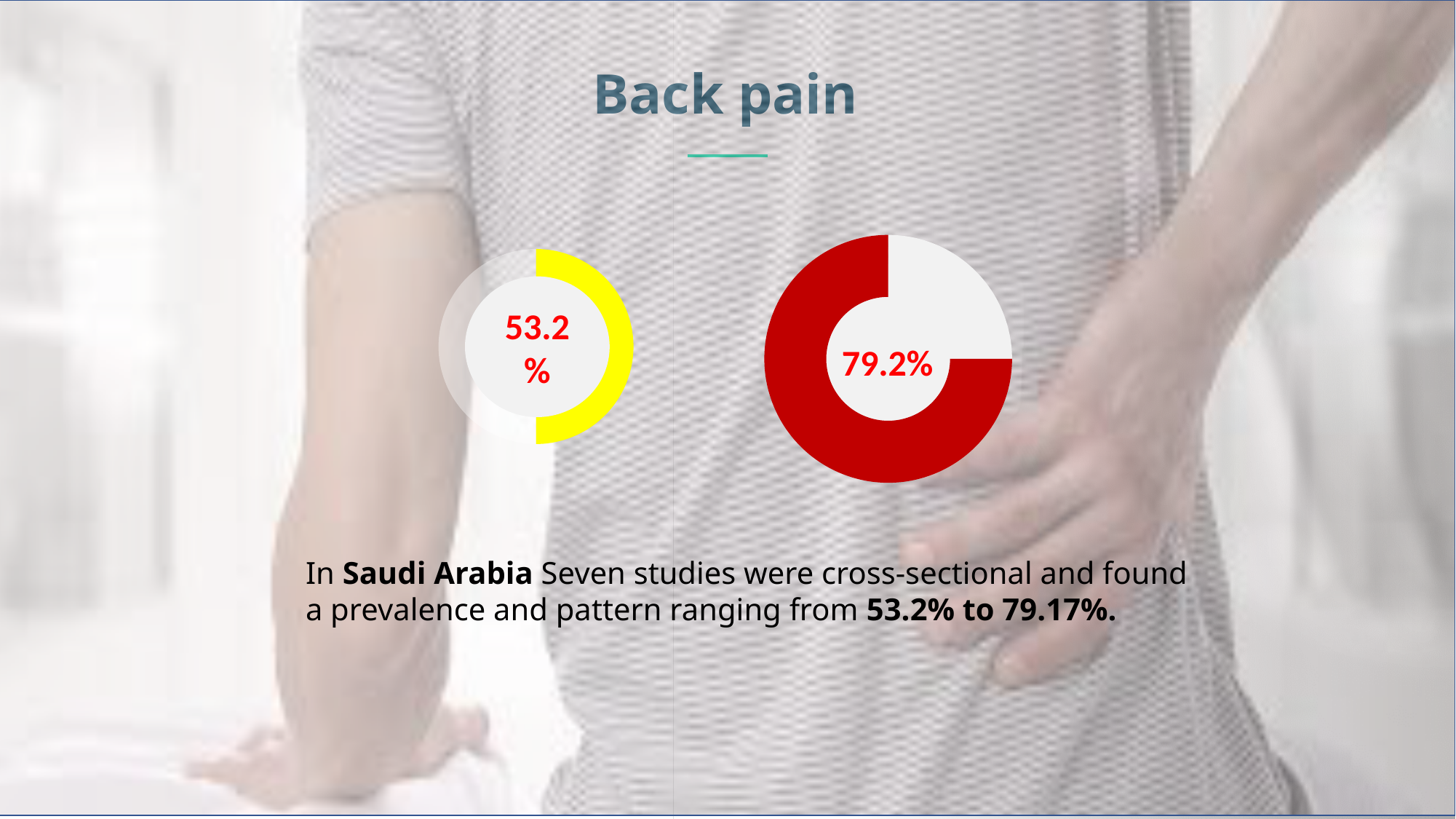
What value is shown in the centre of the left donut chart? 53.2% Which donut chart shows the smallest value, the left or the right? the left Is the value shown in the left donut chart greater or less than 50%? greater What colour is the filled portion of the right donut chart? red What kind of chart is used to display the two percentages on the slide? donut chart Is the value shown in the right donut chart greater or less than 80%? less How many donut charts are shown on the slide? 2 What is the difference between the value in the right donut chart and the value in the left donut chart? 26% What value is shown in the centre of the right donut chart? 79.2% Which of the two donut charts shows the larger value, the left or the right? the right What colour is the filled portion of the left donut chart? yellow